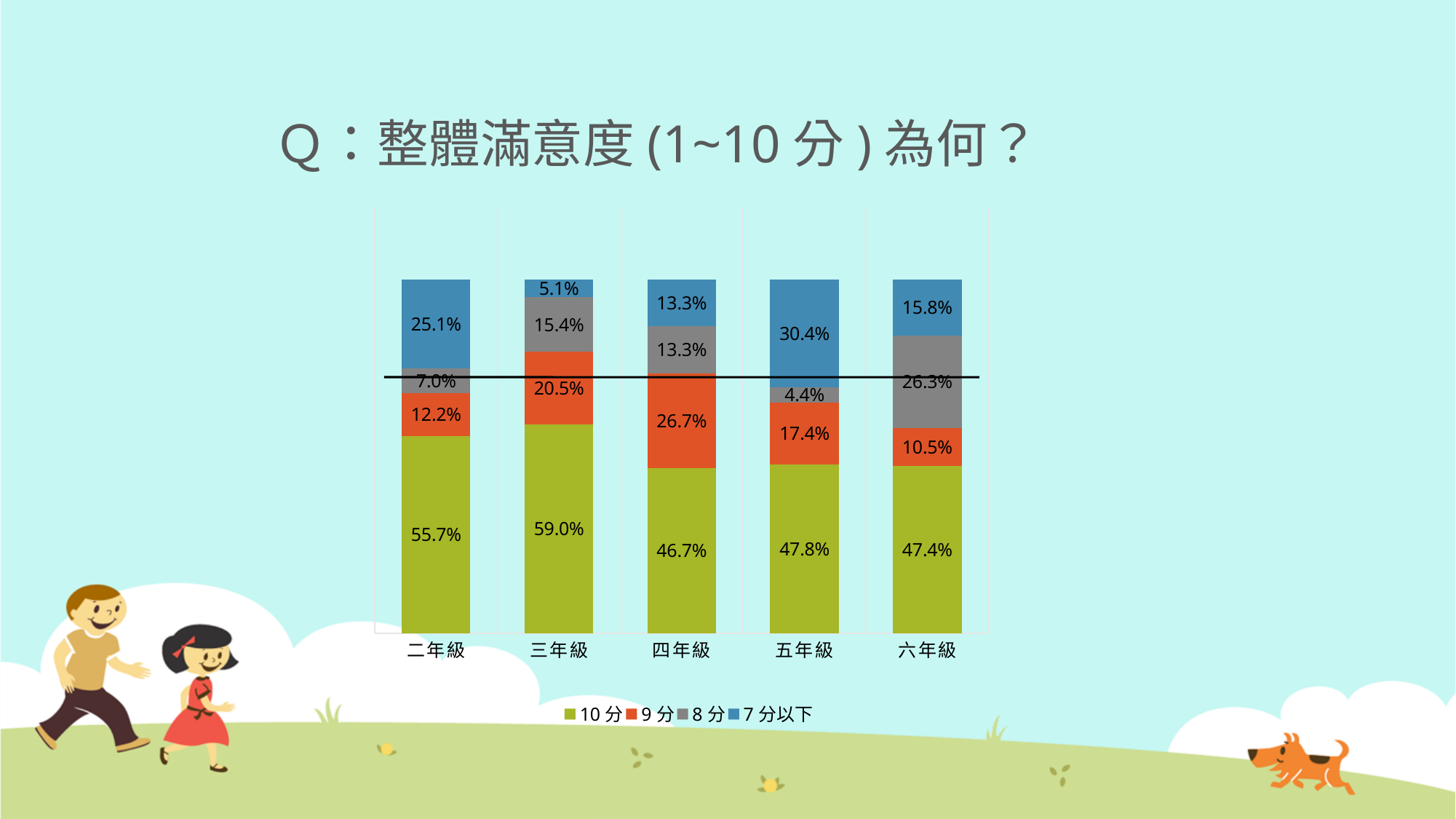
Which legend entry is shown in green? 10 分 How many grade categories are shown on the x axis? 5 What is the value of 8 分 for 六年級? 26.3% What type of chart is shown on the slide? Stacked bar chart Which grade has the highest value for 10 分? 三年級 What is the value of 9 分 for 四年級? 26.7% What is the difference between the 10 分 values for 二年級 and 四年級? 9.0% What is the value of 7 分以下 for 五年級? 30.4% Which grade has the lowest value for 7 分以下? 三年級 What is the value of 10 分 for 三年級? 59.0% How many series does the legend list? 4 Which is larger: the 9 分 value for 三年級 or the 9 分 value for 五年級? 三年級